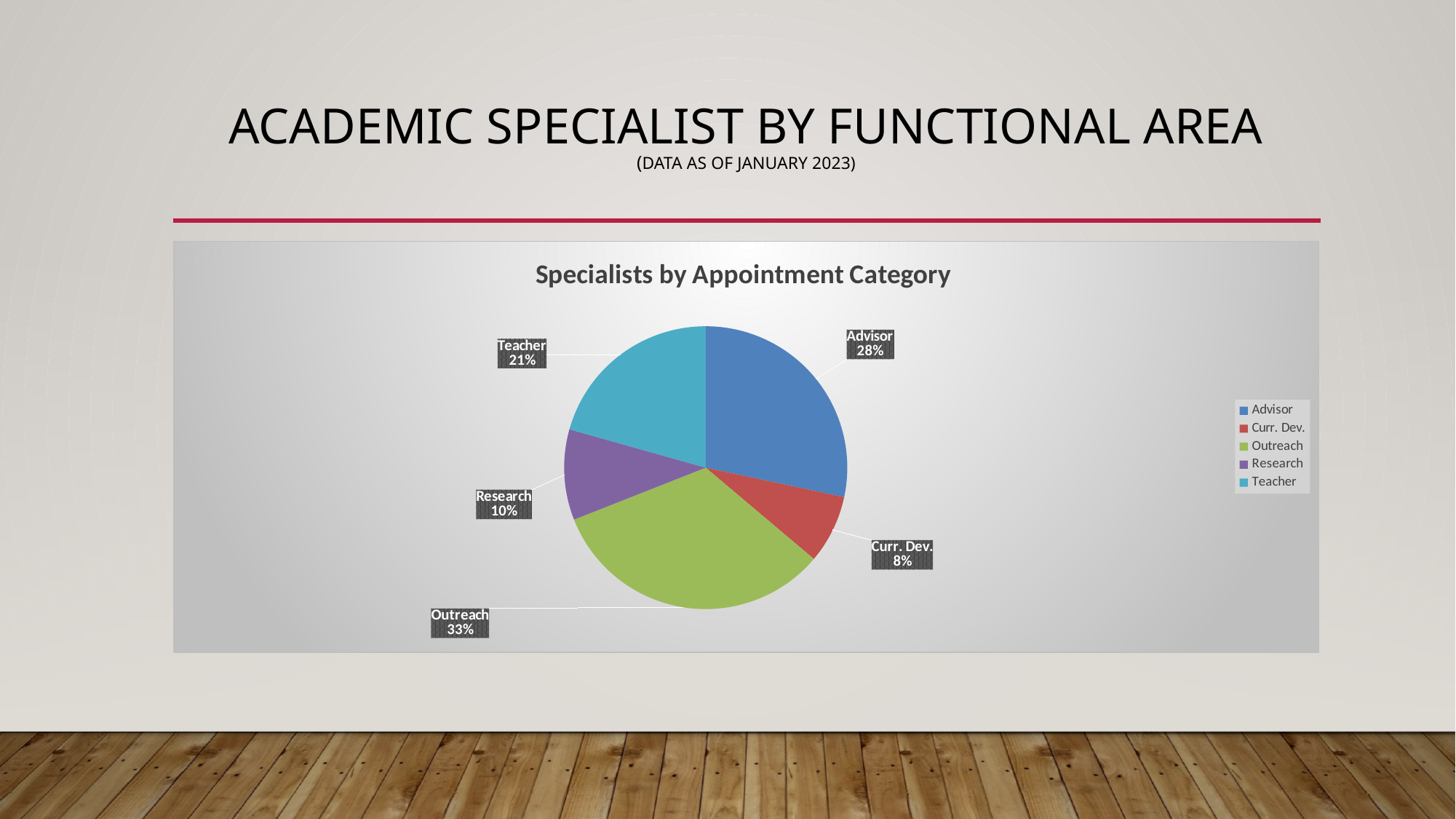
Which appointment category has the largest share of the pie? Outreach How many entries does the legend list? 5 What is the title of the chart? Specialists by Appointment Category Which has a larger share, Teacher or Research? Teacher What kind of chart is shown on the slide? Pie chart What percentage is shown for Teacher? 21% What share of the pie does Outreach represent? 33% What is the difference in percentage points between Outreach and Advisor? 5 How many categories are shown in the pie chart? 5 What percentage is shown for Curr. Dev.? 8% What percentage is shown for Advisor? 28% Which appointment category has the smallest share of the pie? Curr. Dev.